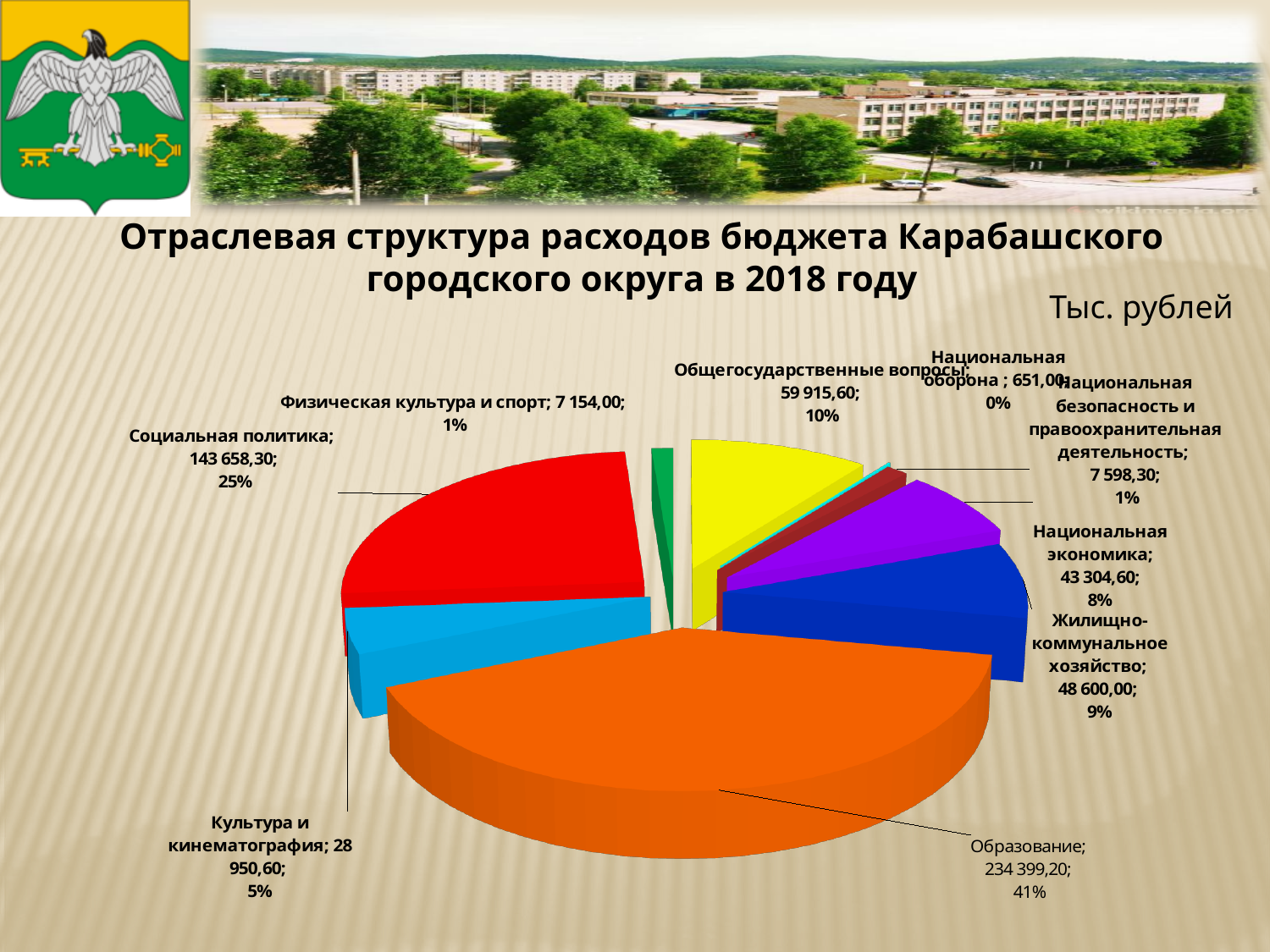
What kind of chart is shown on the slide? Pie chart What share of the pie does Социальная политика represent? 25% What is the value for Национальная оборона? 651,00 What is the value for Образование? 234 399,20 What share of the pie does Общегосударственные вопросы represent? 10% How many categories (slices) does the pie chart show? 9 Which category has the smallest share of the pie? Национальная оборона What is the value for Жилищно-коммунальное хозяйство? 48 600,00 Which category has the largest share of the pie? Образование What is the value for Социальная политика? 143 658,30 What is the difference between the values for Образование and Социальная политика? 90 740,90 Which is larger, Национальная экономика or Жилищно-коммунальное хозяйство? Жилищно-коммунальное хозяйство